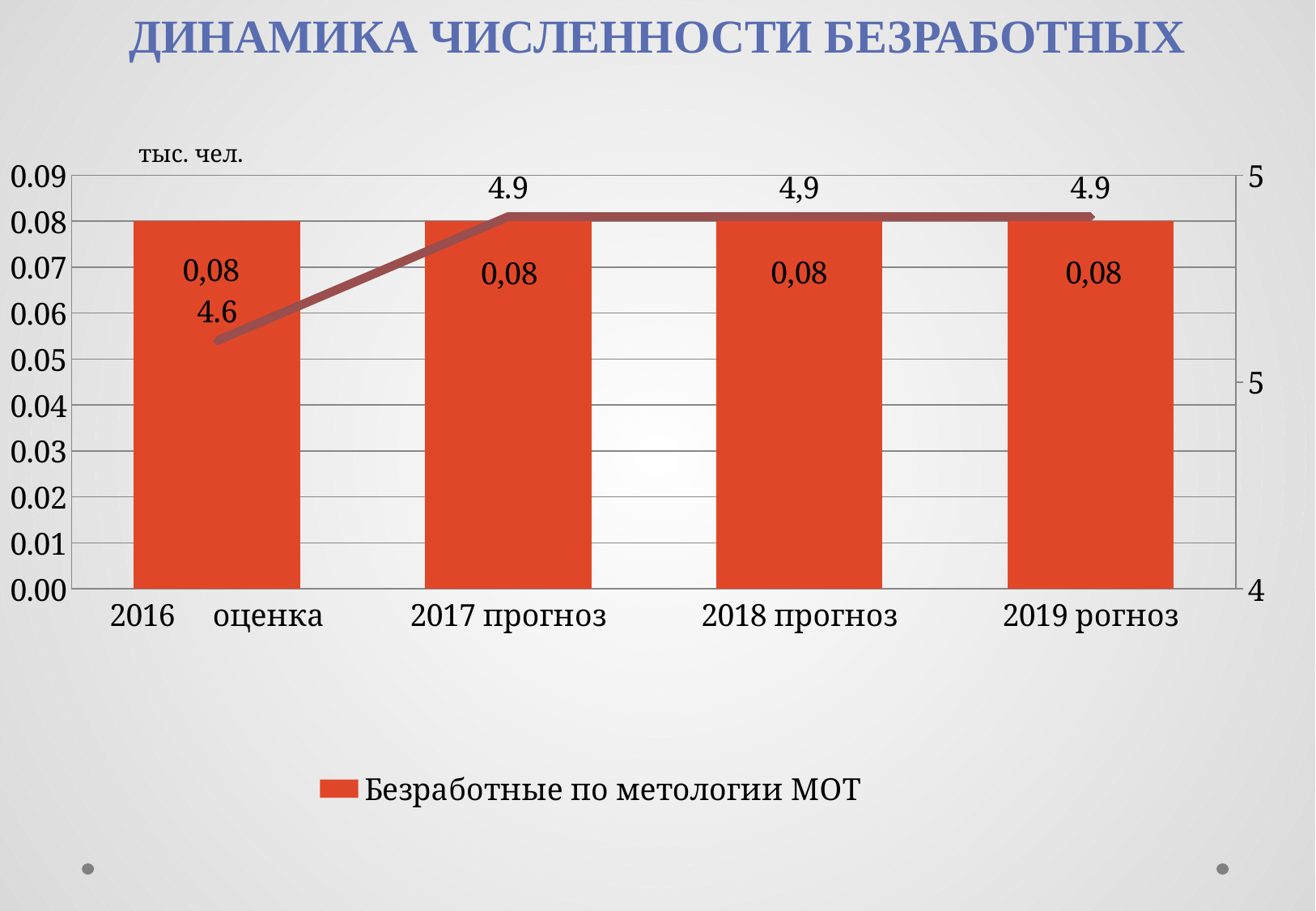
Which category has the lowest line value? 2016 оценка What series name is shown in the legend? Безработные по метологии МОТ How many series does the legend list? 1 What value does the line show for 2016 оценка? 4.6 What value does the line show for 2018 прогноз? 4,9 What is the value of the bar for 2017 прогноз? 0,08 What kind of chart is this? Bar chart combined with a line What is the value of the bar for 2019 рогноз? 0,08 How many categories are shown on the x axis? 4 Does the line rise or fall from 2016 оценка to 2017 прогноз? Rises What is the title of the chart? ДИНАМИКА ЧИСЛЕННОСТИ БЕЗРАБОТНЫХ What is the difference between the line values for 2017 прогноз and 2016 оценка? 0.3